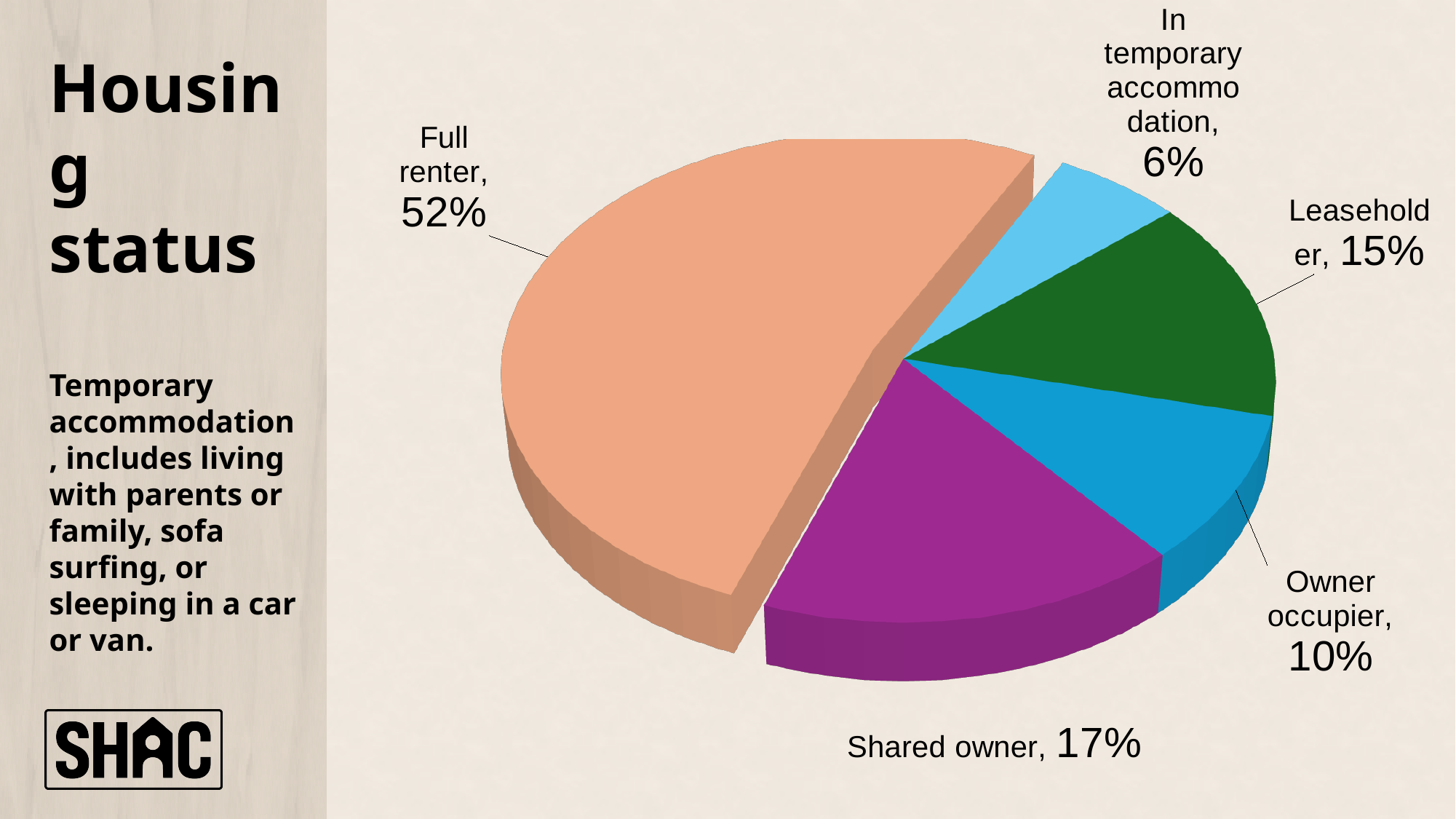
What is the title of the slide containing the chart? Housing status What type of chart is shown on the slide? Pie chart What is the value for Owner occupier? 10% What percentage of the pie is Full renter? 52% What percentage is labelled for Leaseholder? 15% Which category has the smallest slice of the pie? In temporary accommodation Which is larger, Leaseholder or Owner occupier? Leaseholder What percentage is shown for In temporary accommodation? 6% How many categories are shown in the pie chart? 5 What share is shown for Shared owner? 17% Which category has the largest slice of the pie? Full renter What is the difference in percentage points between Full renter and Shared owner? 35